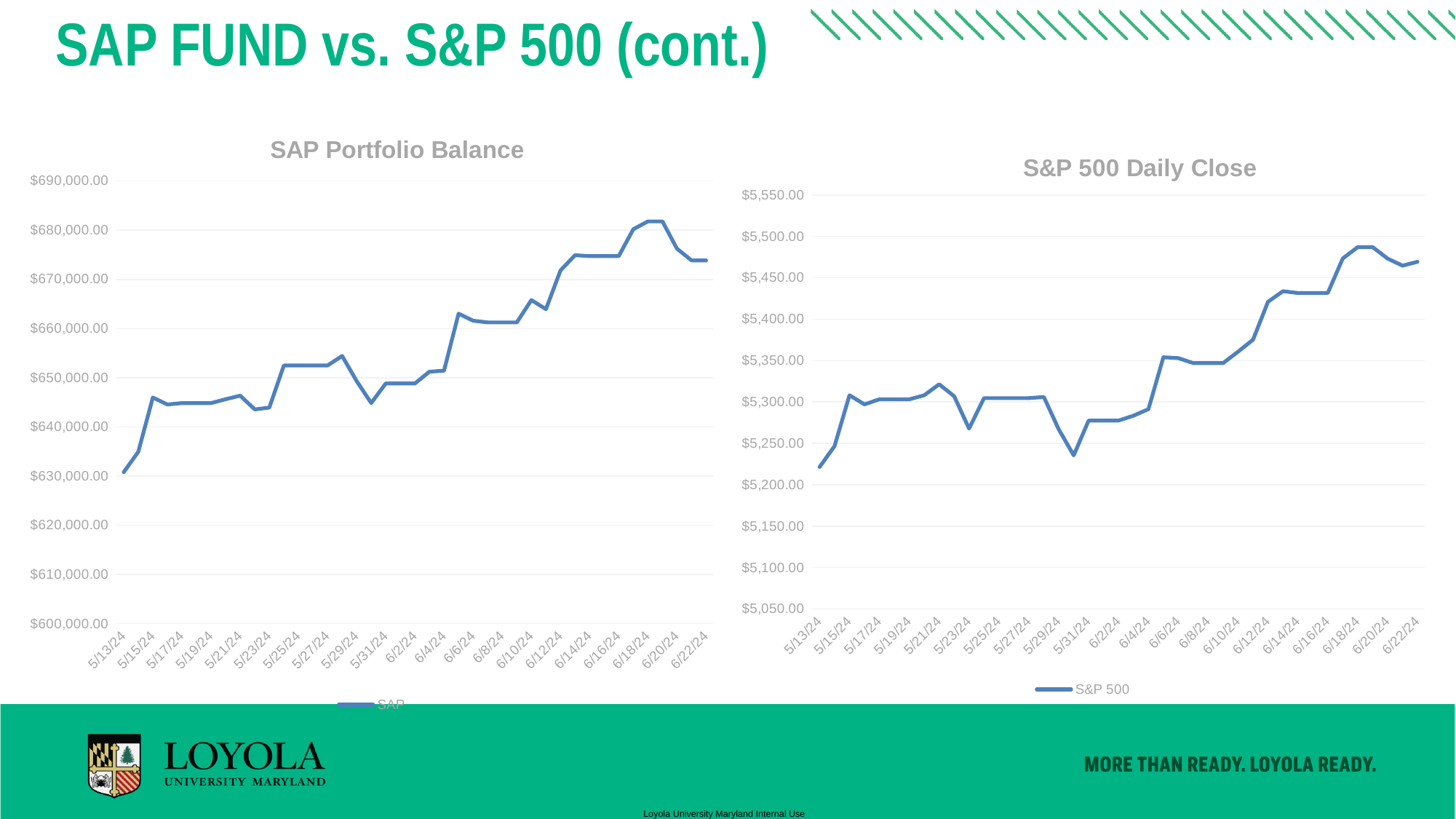
What kind of chart is the S&P 500 Daily Close chart? line chart What is the title of the chart on the right side of the slide? S&P 500 Daily Close In the SAP Portfolio Balance chart, do values overall rise or fall from 5/13/24 to 6/22/24? rise What kind of chart is the SAP Portfolio Balance chart? line chart In the SAP Portfolio Balance chart, is the value on 6/22/24 greater or less than $670,000.00? greater In the SAP Portfolio Balance chart, which is larger, the value on 5/13/24 or the value on 6/22/24? 6/22/24 In the S&P 500 Daily Close chart, do values overall rise or fall from 5/13/24 to 6/22/24? rise In the S&P 500 Daily Close chart, is the value on 5/13/24 greater or less than $5,250.00? less What is the legend entry on the SAP Portfolio Balance chart? SAP In the SAP Portfolio Balance chart, is the value on 5/13/24 greater or less than $640,000.00? less How many series does the legend of the S&P 500 Daily Close chart list? 1